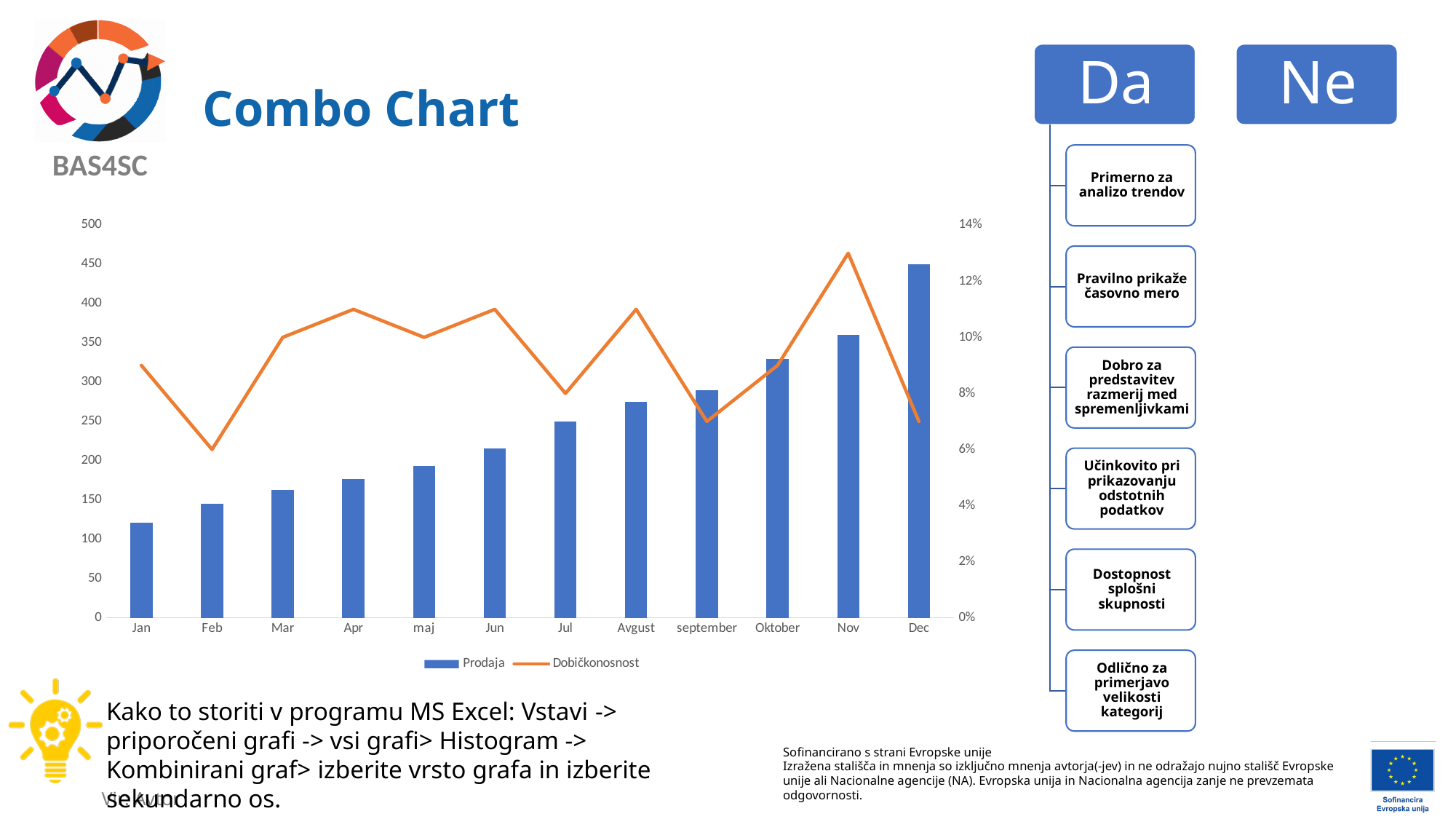
Which month has the lowest Prodaja bar? Jan Is the Prodaja value for Jan greater or less than 150? less Which month has the highest Prodaja bar? Dec Do the Prodaja bars rise or fall from Jan to Dec? Rise What kind of chart is shown on the slide? A combo chart combining a bar chart and a line chart Which month has the larger Prodaja bar, Oktober or Nov? Nov How many series does the chart legend list? 2 In which month does the Dobičkonosnost line reach its highest point? Nov How many categories (months) are shown on the x axis of the chart? 12 Is the Prodaja value for Dec greater or less than 400? greater Is the Dobičkonosnost value for Nov greater or less than 12%? greater In which month does the Dobičkonosnost line reach its lowest point? Feb